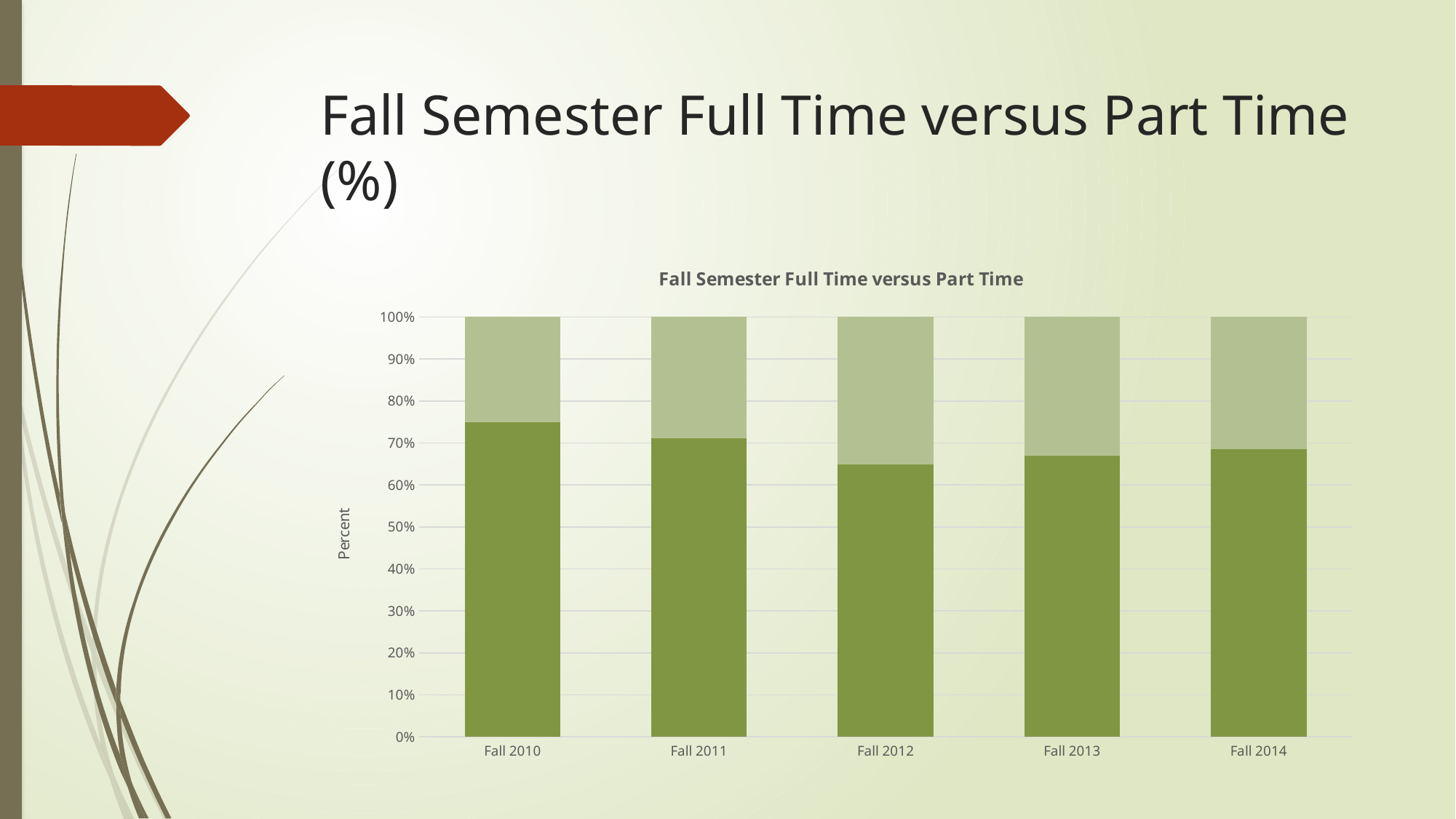
What is the total height of each stacked bar in the chart? 100% In which fall semester is the dark green (lower) segment the smallest? Fall 2012 What kind of chart is shown on the slide? Stacked bar chart What is the label on the vertical axis of the chart? Percent In which fall semester is the dark green (lower) segment the largest? Fall 2010 Is the dark green (lower) segment for Fall 2013 greater or less than 70%? less Which has a larger dark green (lower) segment, Fall 2010 or Fall 2012? Fall 2010 What is the title of the chart? Fall Semester Full Time versus Part Time Is the dark green (lower) segment for Fall 2012 greater or less than 70%? less Is the dark green (lower) segment for Fall 2014 greater or less than 60%? greater How many fall semesters are shown on the x axis of the chart? 5